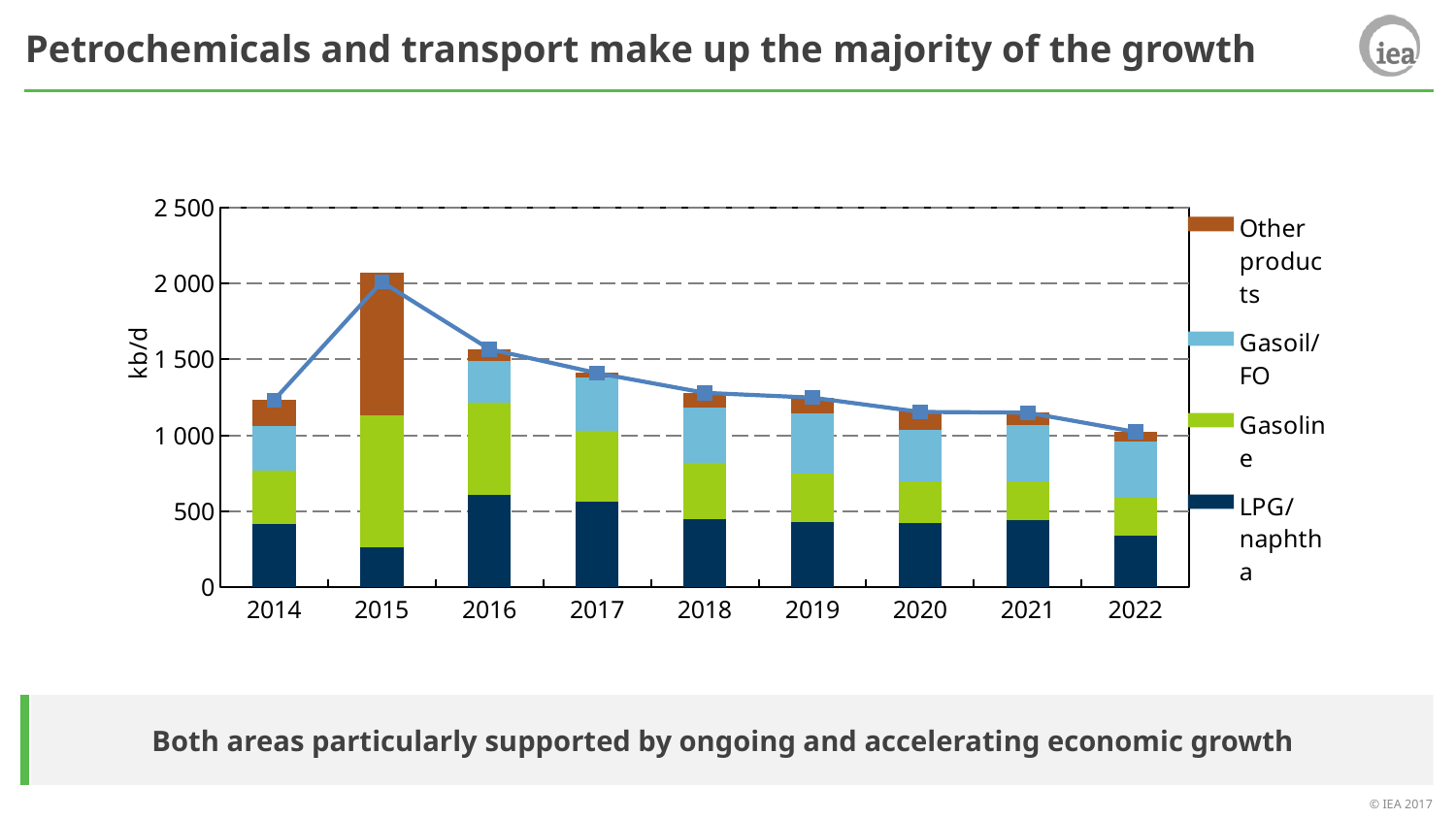
Which year has the highest total bar in the chart? 2015 Which series is shown in dark blue at the bottom of each stacked bar? LPG/naphtha How many series does the chart legend list? 4 Do the total bars rise or fall from 2016 to 2022? fall Which year has the lowest total bar in the chart? 2022 Is the total bar for 2014 greater or less than 1 000 kb/d? greater Is the total bar for 2020 greater or less than 1 000 kb/d? greater How many years are shown on the x axis of the chart? 9 What unit is shown on the y axis of the chart? kb/d Which year has a larger total bar, 2014 or 2015? 2015 Is the total bar for 2017 greater or less than 1 500 kb/d? less What kind of chart is shown on the slide? Stacked bar chart with a line